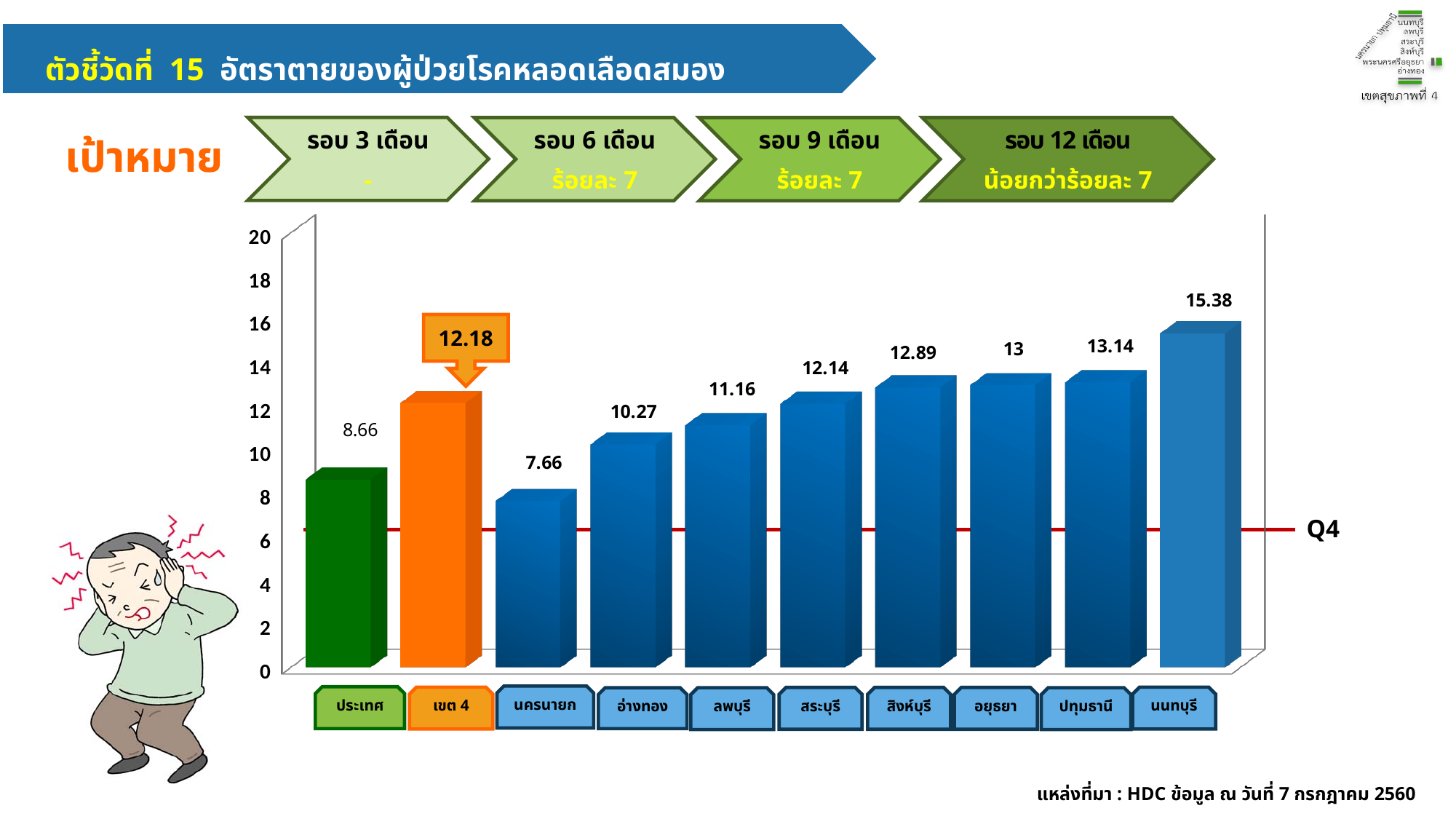
Which category has the lowest value? นครนายก What label is shown at the right end of the red horizontal line? Q4 Which category has the highest value? นนทบุรี What is the difference between the values for นนทบุรี and นครนายก? 7.72 What is the value for เขต 4? 12.18 How many categories are shown on the x axis? 10 What is the value for สระบุรี? 12.14 Is the value for ปทุมธานี greater or less than 12? greater What kind of chart is shown on the slide? bar chart What is the value for ประเทศ? 8.66 What is the value for นนทบุรี? 15.38 Which is larger, the value for อ่างทอง or the value for ลพบุรี? ลพบุรี